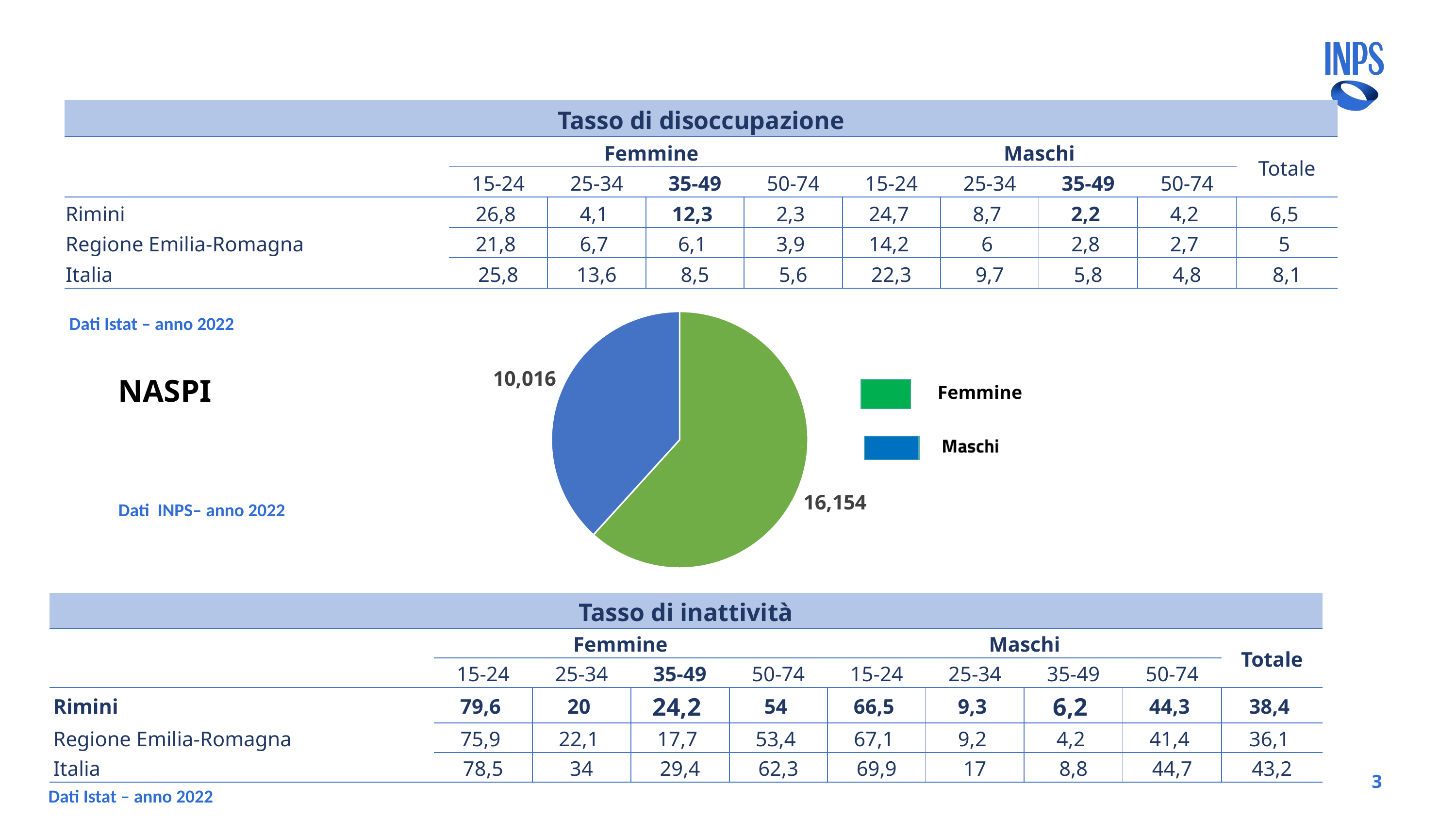
What kind of chart is shown in the middle of the slide under the NASPI heading? pie chart In the NASPI pie chart, what is the value for Maschi? 10,016 How many entries does the legend of the NASPI pie chart list? 2 In the NASPI pie chart, what is the value for Femmine? 16,154 In the NASPI pie chart, which category has the largest slice? Femmine In the NASPI pie chart, what is the difference between the Femmine value and the Maschi value? 6,138 In the NASPI pie chart, what is the total of the two slices? 26,170 In the NASPI pie chart, is the value for Femmine larger or smaller than the value for Maschi? larger How many slices does the NASPI pie chart have? 2 In the NASPI pie chart, what share of the total does the Femmine slice represent? 61.7% In the NASPI pie chart legend, which category is shown in blue? Maschi In the NASPI pie chart, which category has the smallest slice? Maschi